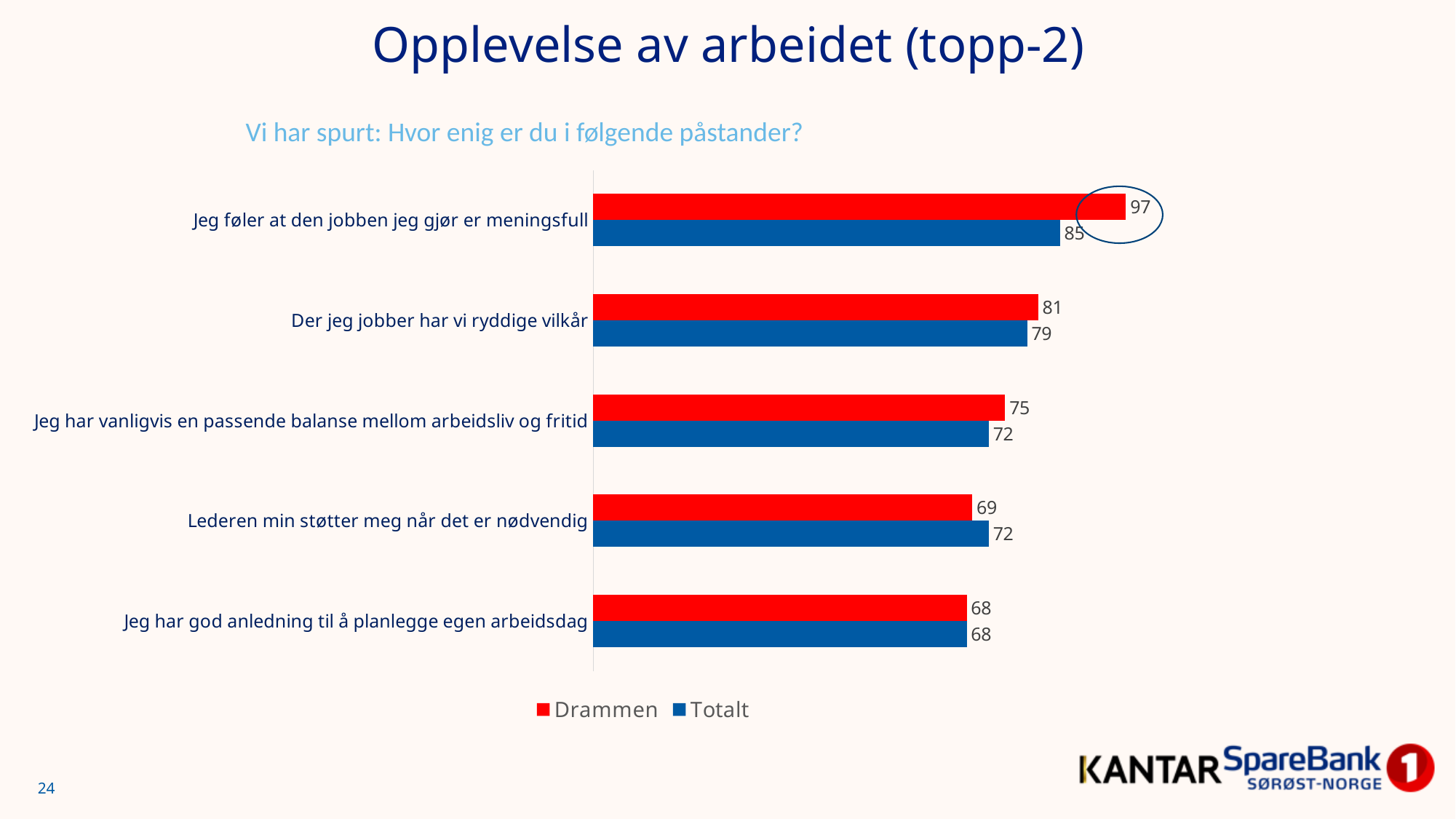
What kind of chart is shown on the slide? Bar chart Which colour represents the Drammen series in the chart? Red For "Lederen min støtter meg når det er nødvendig", which series has the larger value, Drammen or Totalt? Totalt What is the difference between the Drammen and Totalt values for "Jeg føler at den jobben jeg gjør er meningsfull"? 12 What is the Drammen value for "Lederen min støtter meg når det er nødvendig"? 69 How many statements are shown in the chart? 5 What is the Drammen value for "Jeg føler at den jobben jeg gjør er meningsfull"? 97 Which statement has the lowest Totalt value? Jeg har god anledning til å planlegge egen arbeidsdag How many series does the legend list? 2 What is the difference between the Drammen and Totalt values for "Jeg har vanligvis en passende balanse mellom arbeidsliv og fritid"? 3 What is the Totalt value for "Der jeg jobber har vi ryddige vilkår"? 79 Which statement has the highest Drammen value? Jeg føler at den jobben jeg gjør er meningsfull